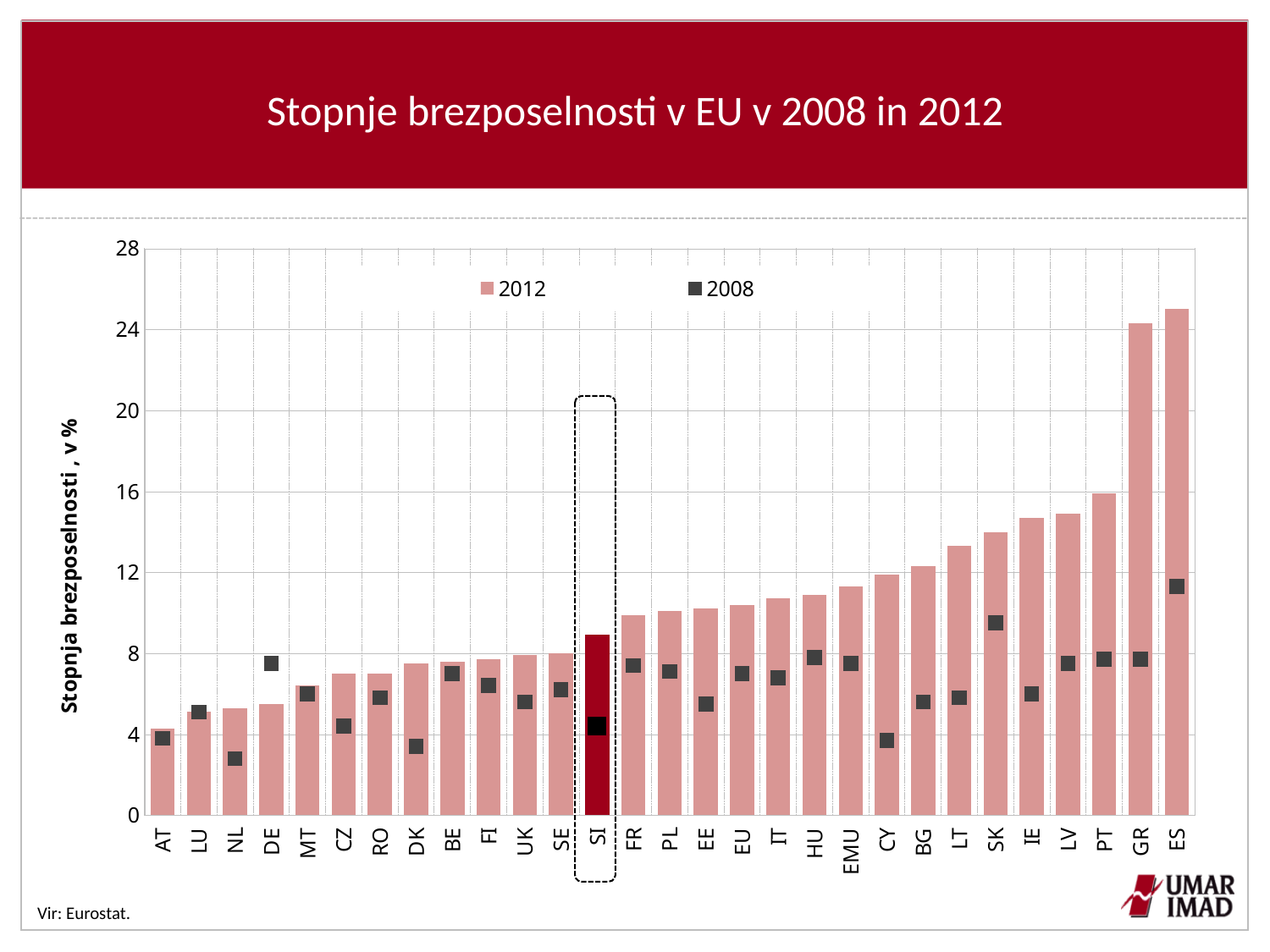
Is the 2012 value for SI greater or less than 8? greater Which country is highlighted with a dashed outline and a darker bar? SI Which country has the lowest 2008 unemployment rate? NL Is the 2008 value for DE greater or less than 4? greater For DE, which is larger: the 2008 value or the 2012 value? 2008 What kind of chart is shown on the slide? bar chart Which country has the highest 2012 unemployment rate? ES How many countries or regions are shown on the x axis? 29 Which country has the lowest 2012 unemployment rate? AT Is the 2012 value for LT greater or less than 12? greater How many series does the legend list? 2 Do the 2012 bars rise or fall from left to right along the x axis? rise